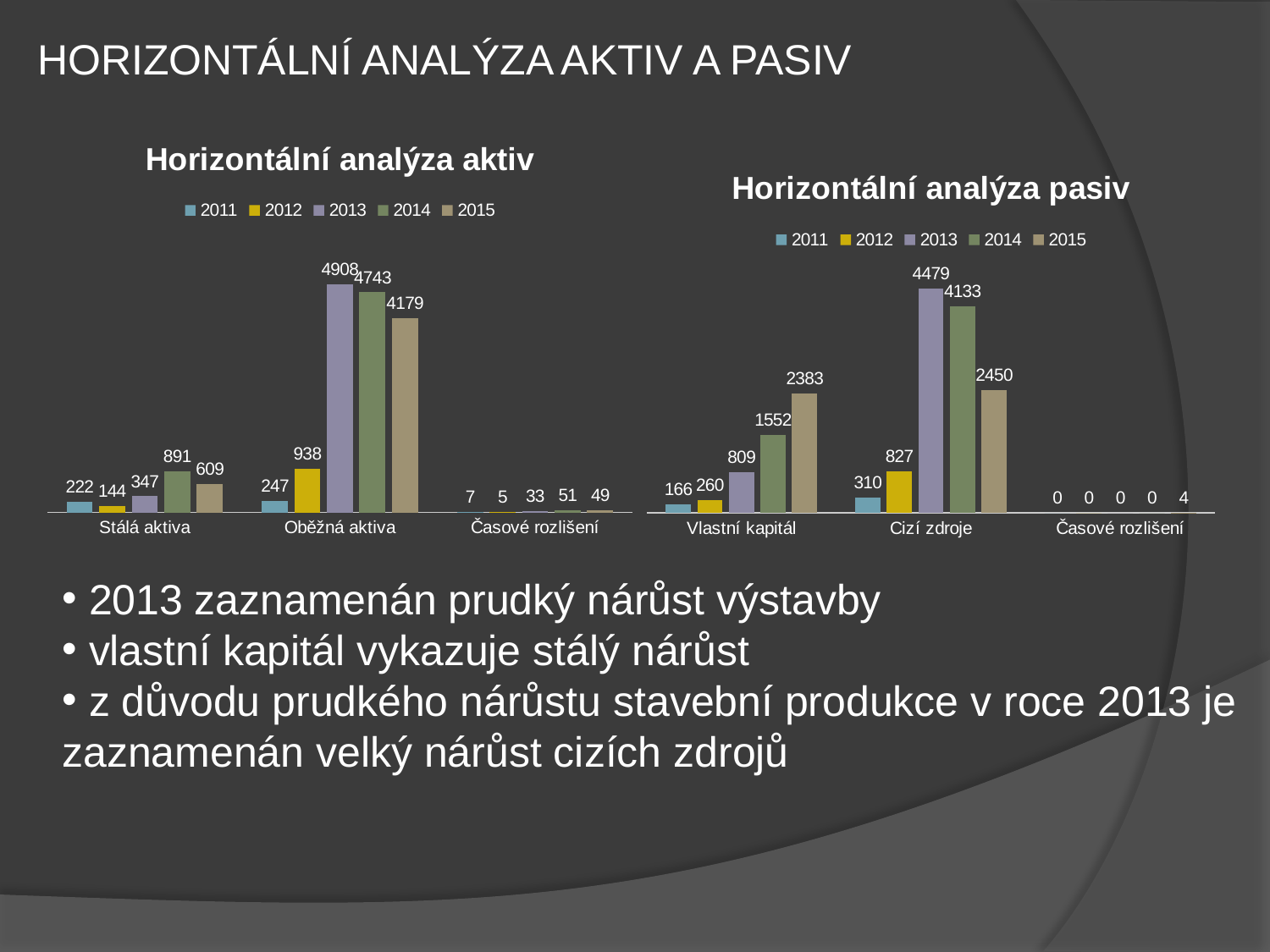
In the 'Horizontální analýza pasiv' chart, what is the difference between the 2015 and 2014 values for Vlastní kapitál? 831 In the 'Horizontální analýza aktiv' chart, what is the value for Oběžná aktiva in 2013? 4908 In the 'Horizontální analýza aktiv' chart, what is the value for Stálá aktiva in 2014? 891 In the 'Horizontální analýza aktiv' chart, which year has the lowest value for Stálá aktiva? 2012 In the 'Horizontální analýza aktiv' chart, what is the difference between the 2013 and 2015 values for Oběžná aktiva? 729 In the 'Horizontální analýza pasiv' chart, what is the value for Cizí zdroje in 2015? 2450 In the 'Horizontální analýza pasiv' chart, do the values for Vlastní kapitál rise or fall from 2011 to 2015? rise In the 'Horizontální analýza pasiv' chart, which is larger: Cizí zdroje in 2014 or Vlastní kapitál in 2014? Cizí zdroje in 2014 How many categories are shown on the x axis of the 'Horizontální analýza pasiv' chart? 3 In the 'Horizontální analýza pasiv' chart, what is the value for Vlastní kapitál in 2012? 260 In the 'Horizontální analýza pasiv' chart, which year has the highest value for Cizí zdroje? 2013 How many series does the legend of the 'Horizontální analýza aktiv' chart list? 5